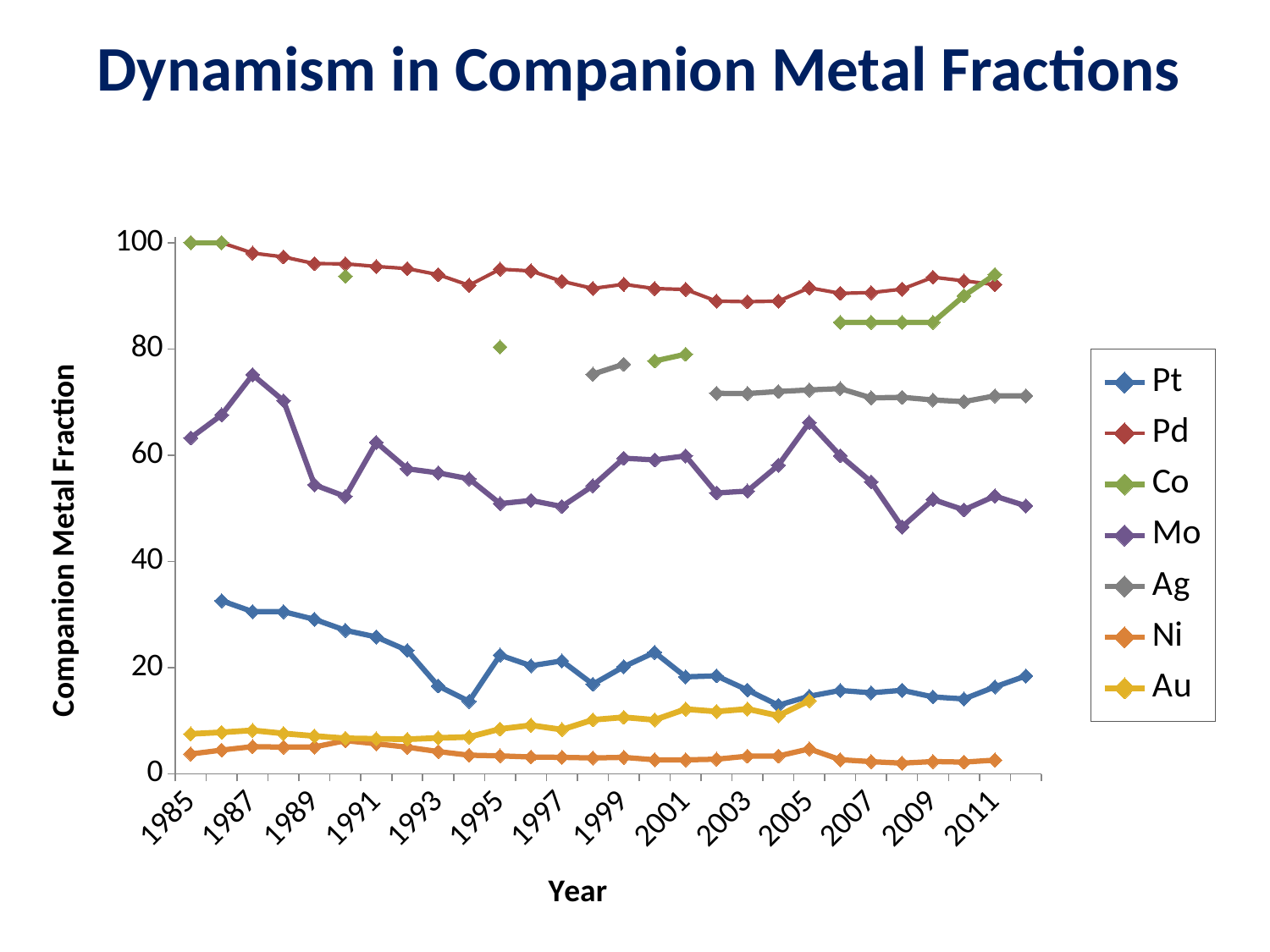
What kind of chart is shown on the slide? line chart Is the value for Pd in 1985 greater or less than 80? greater Which series has the higher value in 2005, Pt or Mo? Mo Is the value for Mo in 1987 greater or less than 60? greater Does the Pt series generally rise or fall from 1985 to 2005? fall What is the title of the chart? Dynamism in Companion Metal Fractions What is the label of the vertical axis? Companion Metal Fraction Which series has the higher value in 1999, Au or Ni? Au Is the value for Ni in 2011 greater or less than 20? less How many series does the legend list? 7